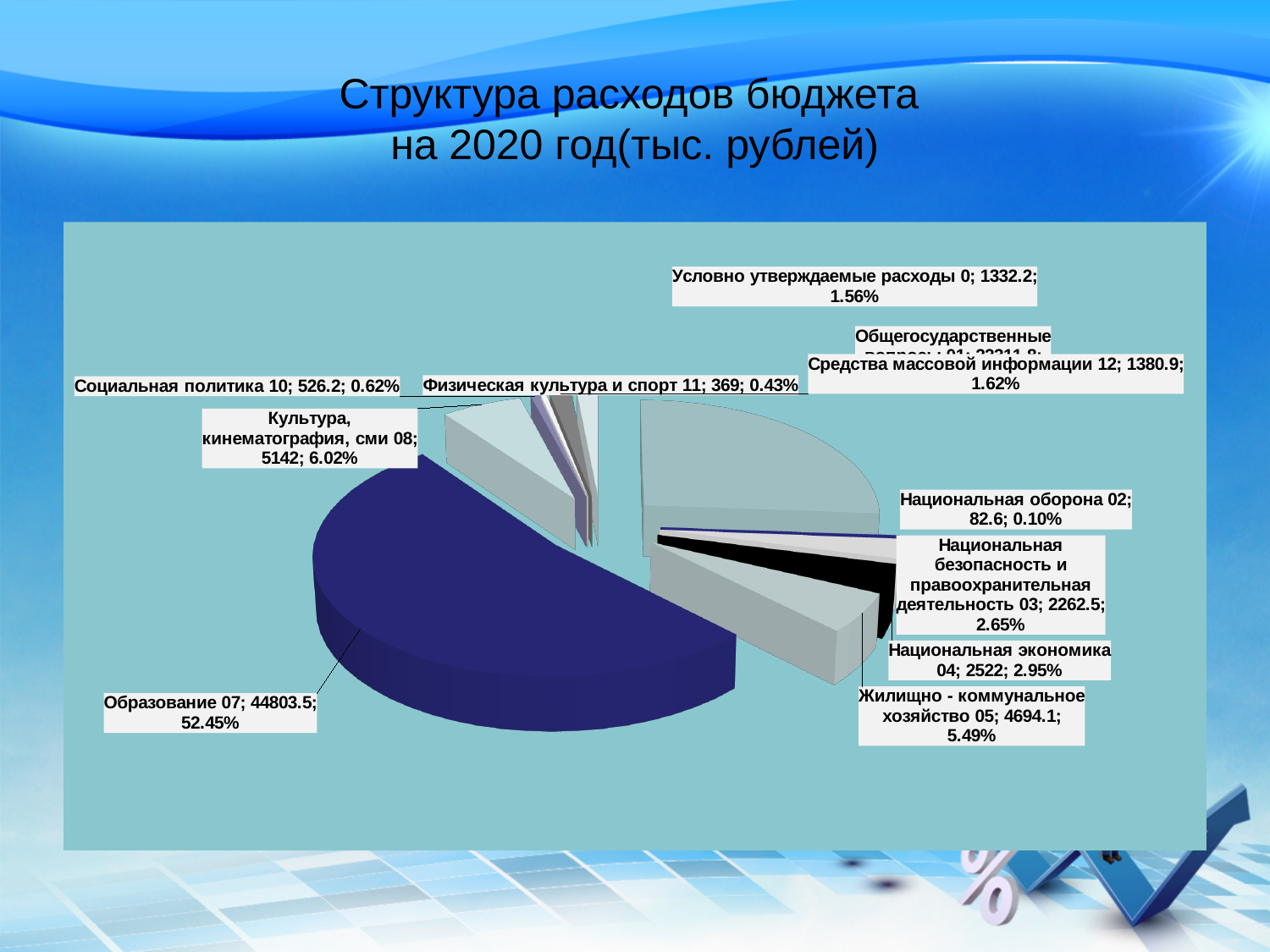
Which category has the largest share of the pie? Образование 07 What is the value for Образование 07? 44803.5 What type of chart is shown on the slide? pie chart What is the title of the chart on the slide? Структура расходов бюджета на 2020 год(тыс. рублей) What is the value for Жилищно-коммунальное хозяйство 05? 4694.1 Which is larger: the value for Средства массовой информации 12 or the value for Условно утверждаемые расходы 0? Средства массовой информации 12 What share of the pie does Образование 07 represent? 52.45% What is the value for Национальная оборона 02? 82.6 What share of the pie does Культура, кинематография, сми 08 represent? 6.02% How many categories are shown in the pie chart? 11 What is the difference between the values for Национальная экономика 04 and Национальная безопасность и правоохранительная деятельность 03? 259.5 Which category has the smallest share of the pie? Национальная оборона 02